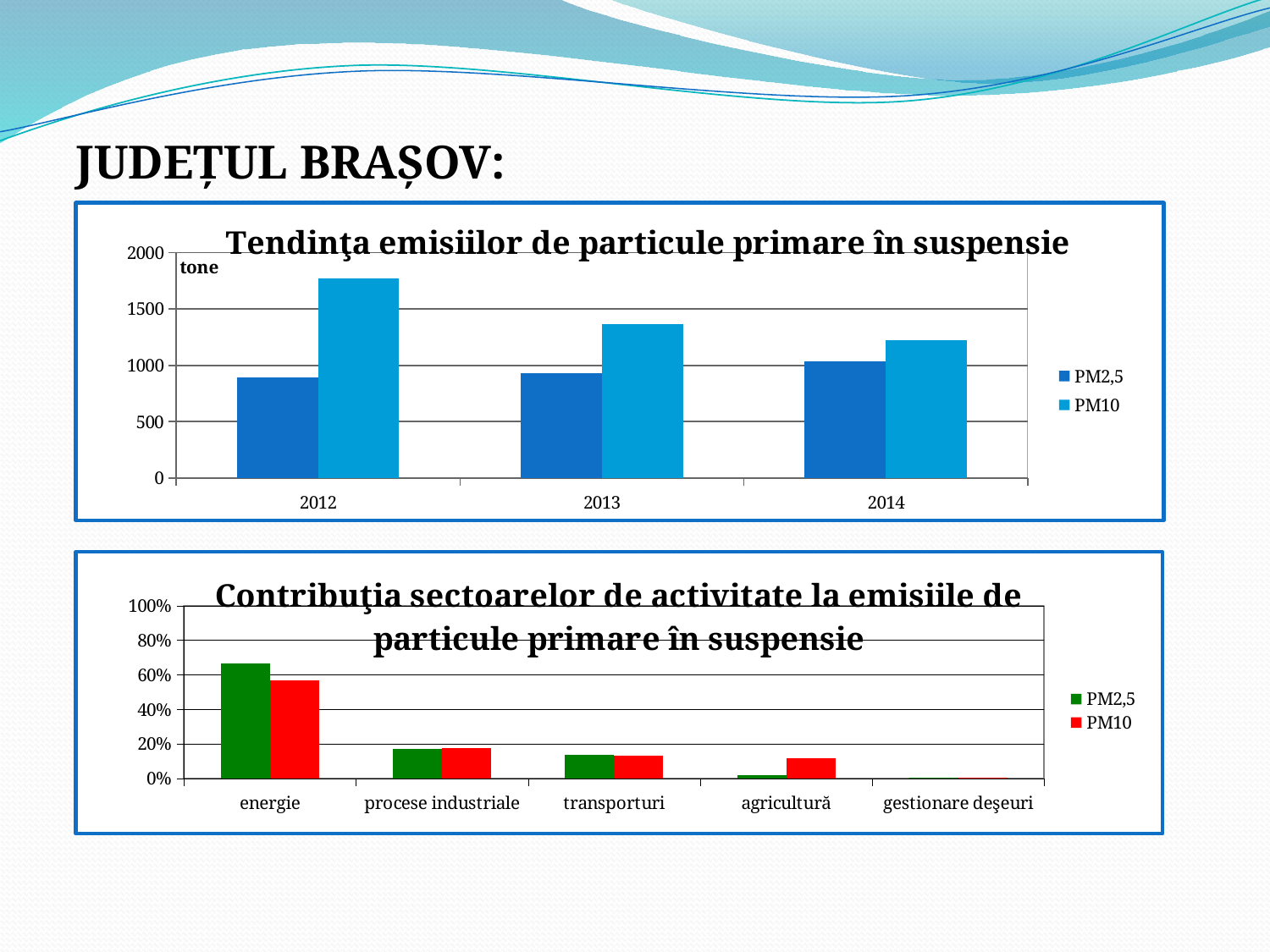
How many series does the legend of the top chart list? 2 In the top chart, which year has the highest PM10 value? 2012 What kind of chart is the top chart, 'Tendinţa emisiilor de particule primare în suspensie'? bar chart In the top chart, is the PM10 value for 2012 greater or less than 1500? greater In the bottom chart, is the PM2,5 value for energie greater or less than 60%? greater What unit is shown on the y axis of the top chart? tone In the top chart, do the PM10 values rise or fall from 2012 to 2014? fall In the top chart, which is larger in 2013: PM2,5 or PM10? PM10 How many sectors are shown on the x axis of the bottom chart, 'Contribuţia sectoarelor de activitate la emisiile de particule primare în suspensie'? 5 How many years are shown on the x axis of the top chart? 3 In the bottom chart, which sector has the highest PM2,5 contribution? energie In the top chart, is the PM2,5 value for 2012 greater or less than 1000? less